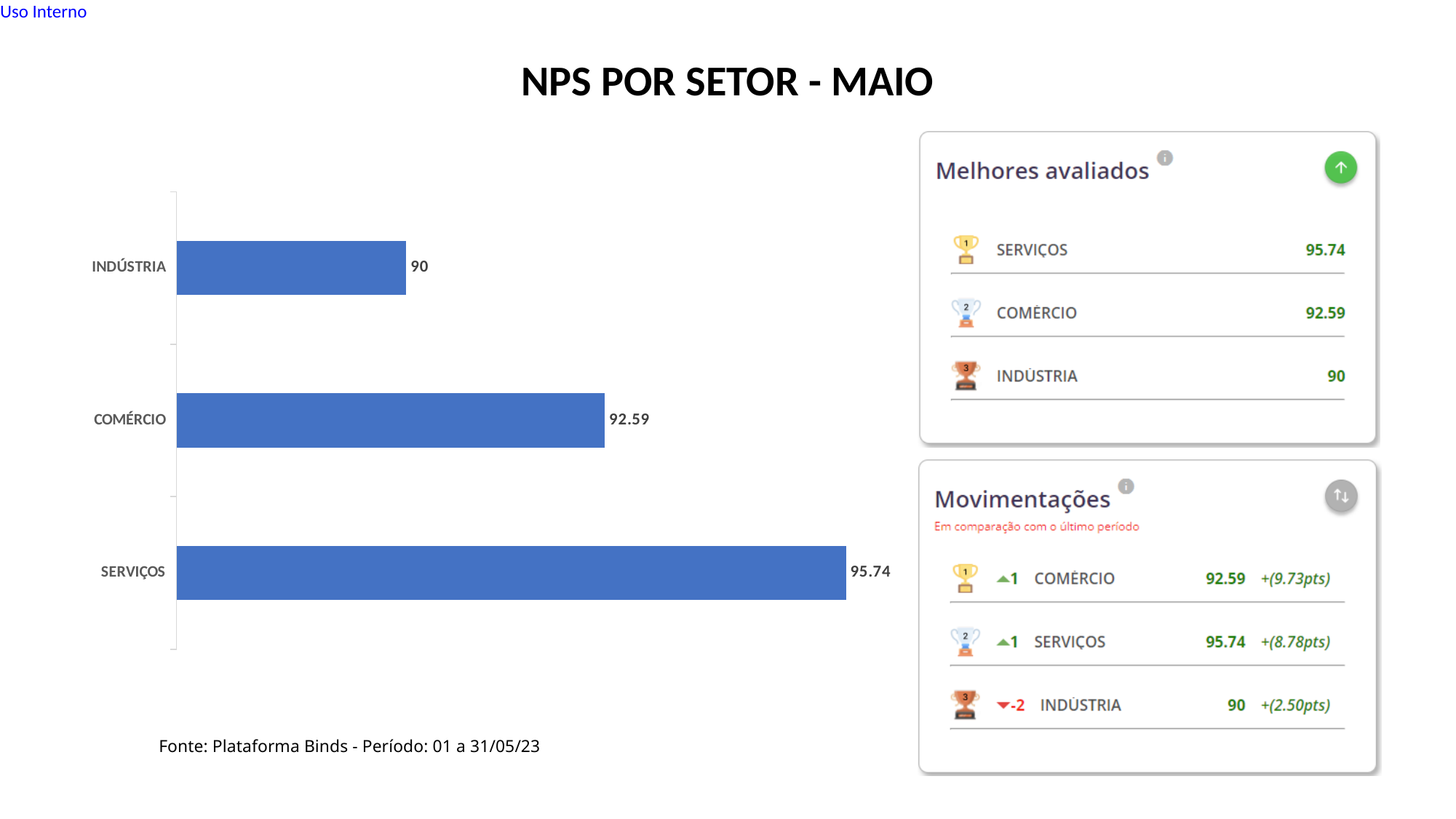
Which sector has the lowest NPS? INDÚSTRIA How many sectors are shown in the chart? 3 What is the NPS value for INDÚSTRIA? 90 What is the NPS value for SERVIÇOS? 95.74 What is the difference between the NPS of SERVIÇOS and INDÚSTRIA? 5.74 Which sector has the highest NPS? SERVIÇOS What is the NPS value for COMÉRCIO? 92.59 What is the title of the chart? NPS POR SETOR - MAIO Which has a higher NPS, INDÚSTRIA or COMÉRCIO? COMÉRCIO What kind of chart is shown on the slide? Bar chart Which has a higher NPS, COMÉRCIO or SERVIÇOS? SERVIÇOS What is the difference between the NPS of COMÉRCIO and INDÚSTRIA? 2.59